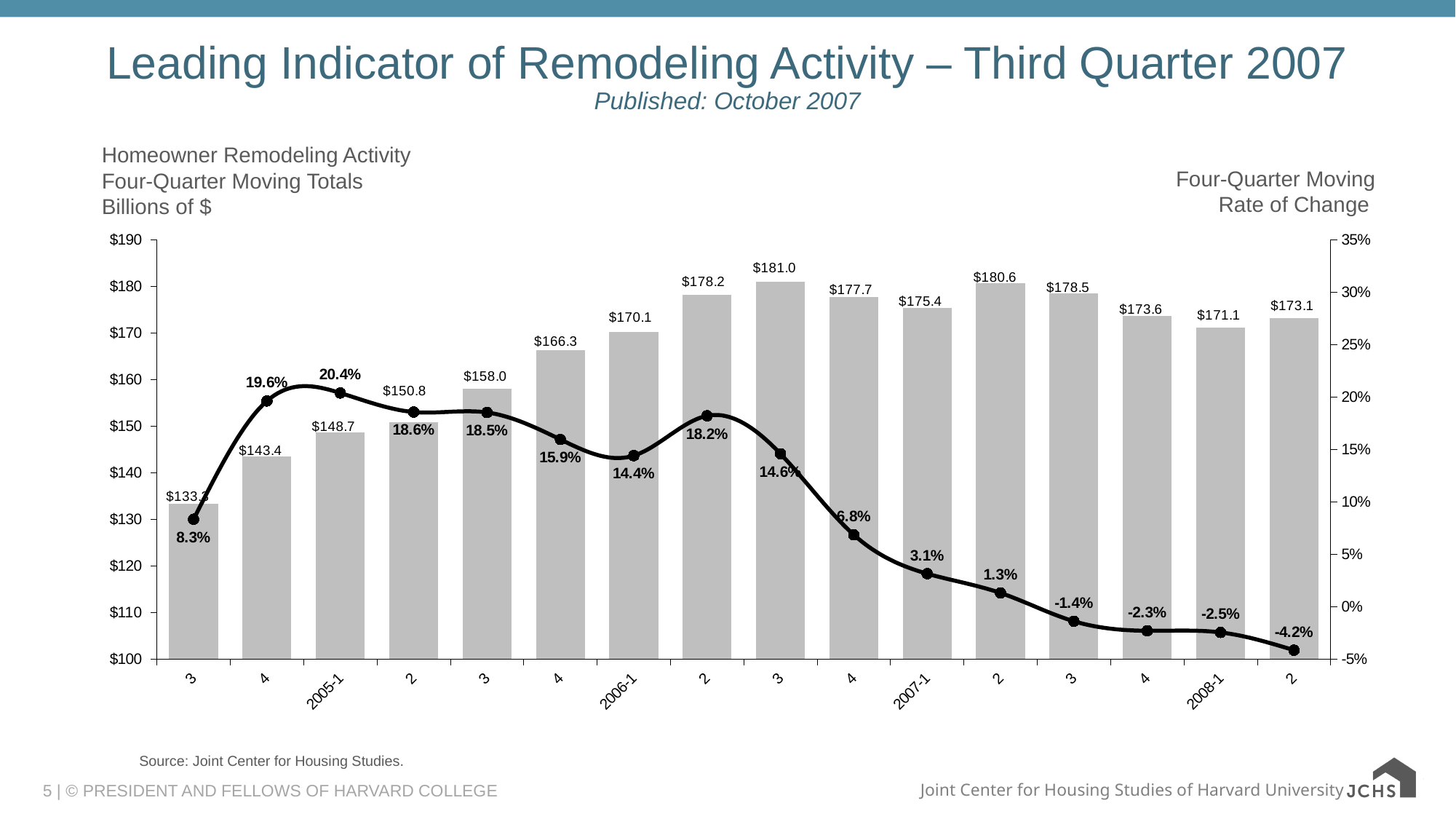
What is the highest four-quarter moving total shown by the bars? $181.0 Which quarter has the highest four-quarter moving rate of change? 2005-1 (20.4%) What is the four-quarter moving rate of change for 2007-1? 3.1% What is the difference between the four-quarter moving totals for 2007-1 and 2006-1? $5.3 billion What kind of chart is shown on the slide? Combination bar and line chart Is the four-quarter moving rate of change for 2008-1 greater or less than 0%? less What is the four-quarter moving rate of change for 2006-1? 14.4% Which has the larger four-quarter moving total, 2007-1 or 2008-1? 2007-1 How many quarters are shown along the x axis? 16 What is the lowest four-quarter moving rate of change shown on the line? -4.2% What is the four-quarter moving total (billions of $) for 2005-1? $148.7 What is the four-quarter moving total (billions of $) for 2008-1? $171.1